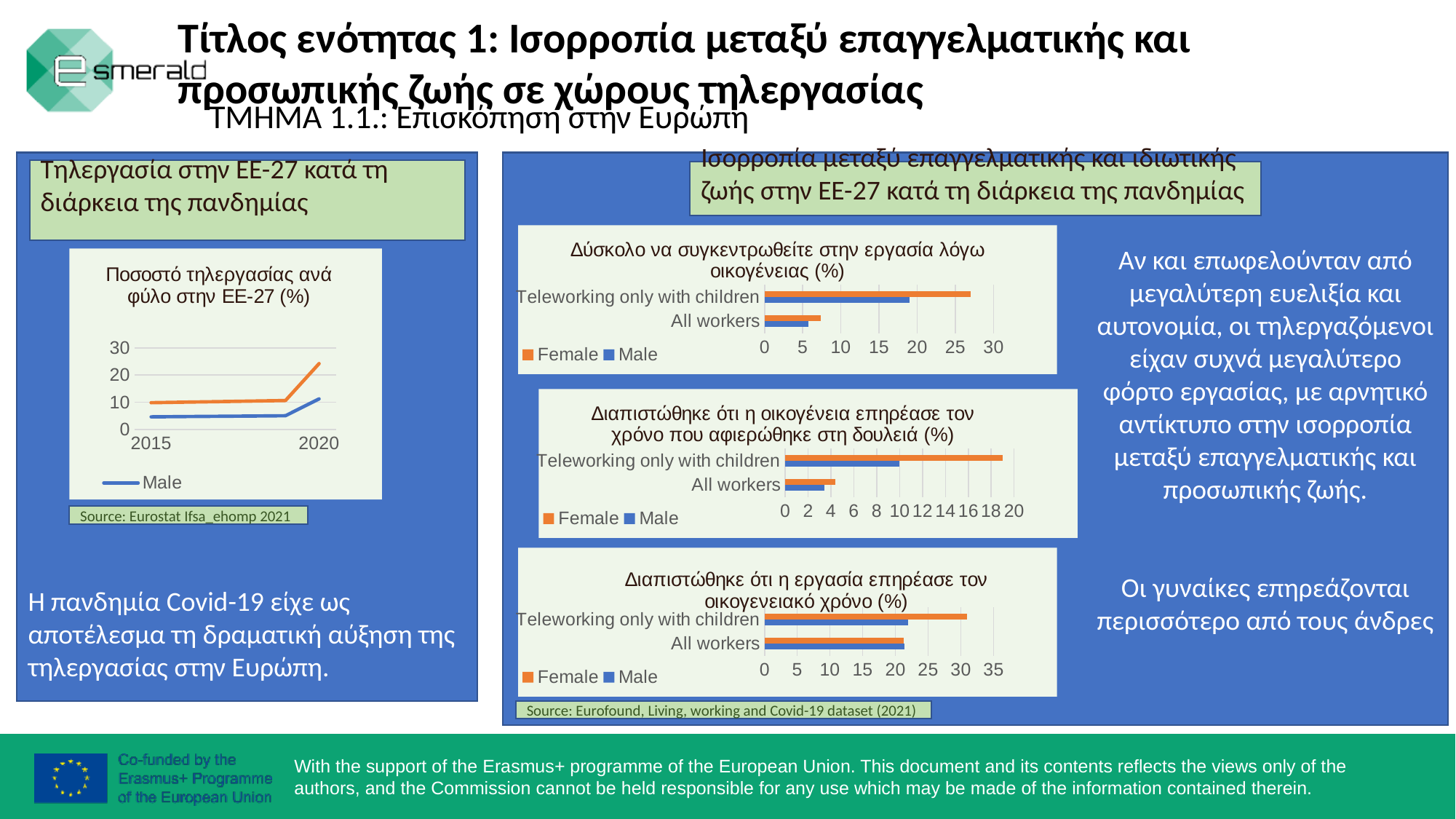
What kind of chart is the 'Ποσοστό τηλεργασίας ανά φύλο στην ΕΕ-27 (%)' chart on the left? line chart In the 'Ποσοστό τηλεργασίας ανά φύλο στην ΕΕ-27 (%)' chart, which years are shown on the x axis? 2015 and 2020 In the 'Ποσοστό τηλεργασίας ανά φύλο στην ΕΕ-27 (%)' chart, does the Male line rise or fall from 2015 to 2020? rise In the 'Διαπιστώθηκε ότι η οικογένεια επηρέασε τον χρόνο που αφιερώθηκε στη δουλειά (%)' chart, is the Female value for 'Teleworking only with children' greater or less than 16? greater In the 'Δύσκολο να συγκεντρωθείτε στην εργασία λόγω οικογένειας (%)' chart, which is larger for 'Teleworking only with children', Female or Male? Female In the 'Διαπιστώθηκε ότι η εργασία επηρέασε τον οικογενειακό χρόνο (%)' chart, is the Female value for 'Teleworking only with children' greater or less than 25? greater In the 'Δύσκολο να συγκεντρωθείτε στην εργασία λόγω οικογένειας (%)' chart, is the Female value for 'Teleworking only with children' greater or less than 25? greater In the 'Διαπιστώθηκε ότι η εργασία επηρέασε τον οικογενειακό χρόνο (%)' chart, which is larger for 'Teleworking only with children', Female or Male? Female In the 'Δύσκολο να συγκεντρωθείτε στην εργασία λόγω οικογένειας (%)' chart, how many series does the legend list? 2 What kind of chart is the 'Δύσκολο να συγκεντρωθείτε στην εργασία λόγω οικογένειας (%)' chart? bar chart In the 'Διαπιστώθηκε ότι η οικογένεια επηρέασε τον χρόνο που αφιερώθηκε στη δουλειά (%)' chart, how many categories are shown? 2